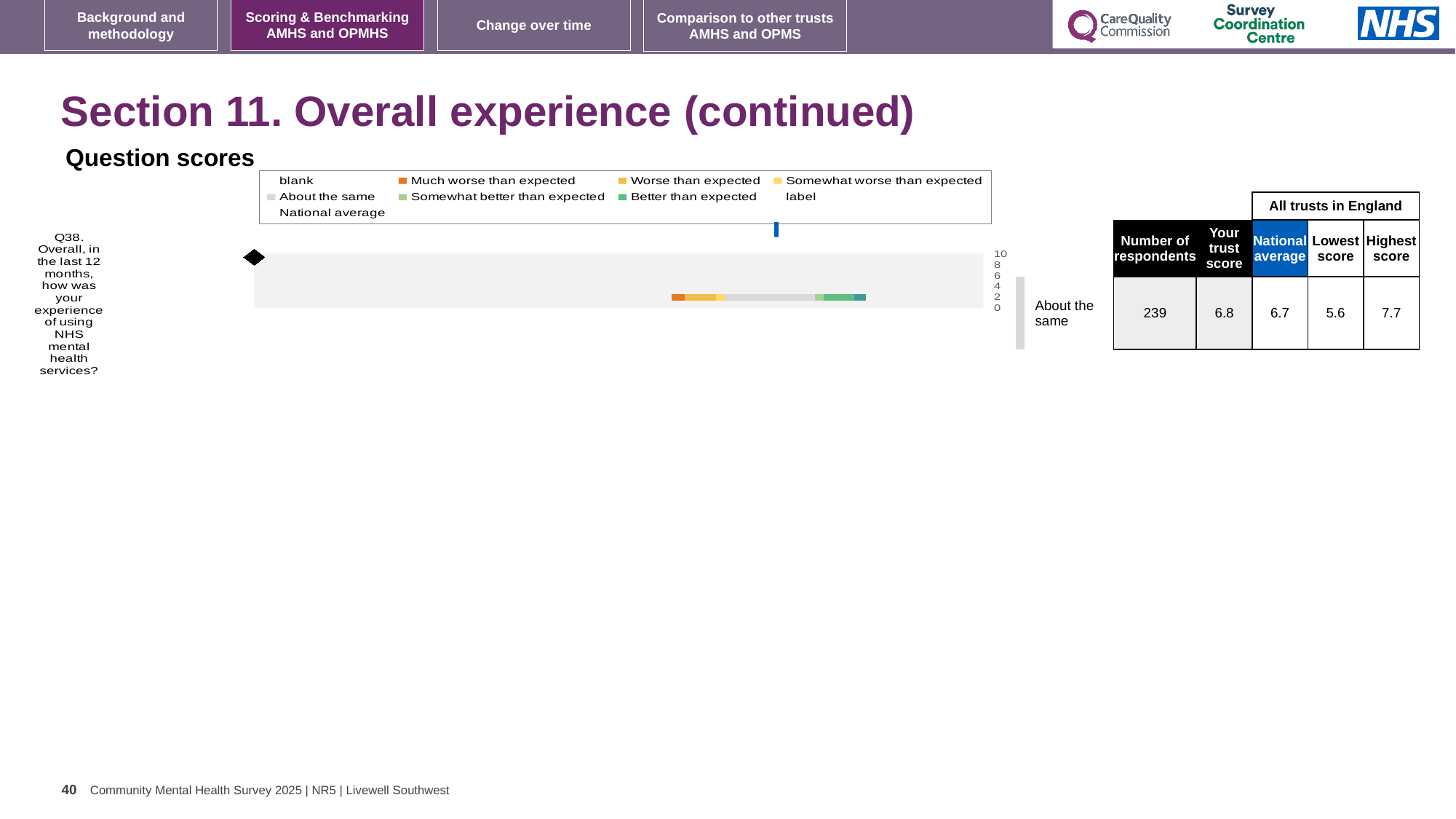
What is the number of respondents for Q38? 239 What is the national average score for Q38? 6.7 Which question number is shown in the Question scores chart? Q38 How many questions are plotted in the Question scores chart? 1 What kind of chart is used to show the Q38 question score? bar chart For Q38, which is larger: the trust's score or the national average? the trust's score What is the difference between the highest and lowest scores for Q38 across all trusts in England? 2.1 What colour represents 'Much worse than expected' in the chart legend? orange What is the lowest score among all trusts in England for Q38? 5.6 What benchmark category is shown for Q38 next to the chart? About the same What is the highest score among all trusts in England for Q38? 7.7 What is the trust's score for Q38? 6.8